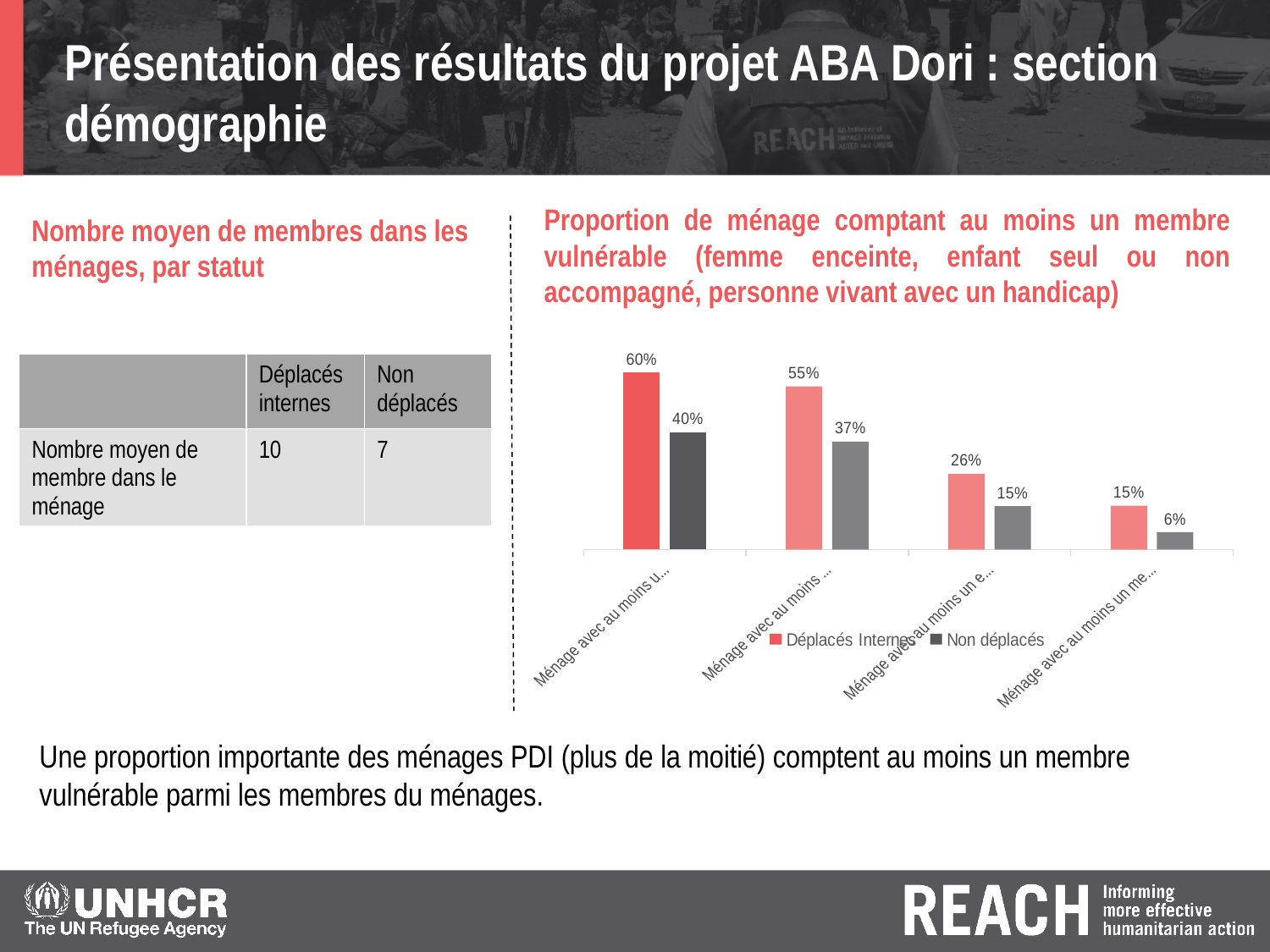
How many category groups are plotted on the chart? 4 What is the value for Déplacés Internes in the third category group? 26% What is the value for Non déplacés in the second category group? 37% Do the Déplacés Internes values rise or fall from left to right across the category groups? fall What is the value for Déplacés Internes in the first (leftmost) category group? 60% How many series does the chart legend list? 2 In the fourth category group, which series has the larger value: Déplacés Internes or Non déplacés? Déplacés Internes What is the difference between Déplacés Internes and Non déplacés in the first category group? 20% What is the value for Non déplacés in the fourth (rightmost) category group? 6% What is the lowest value shown on the chart? 6% Which series has the highest value on the chart, and what is it? Déplacés Internes, 60% What kind of chart is shown on the slide? bar chart